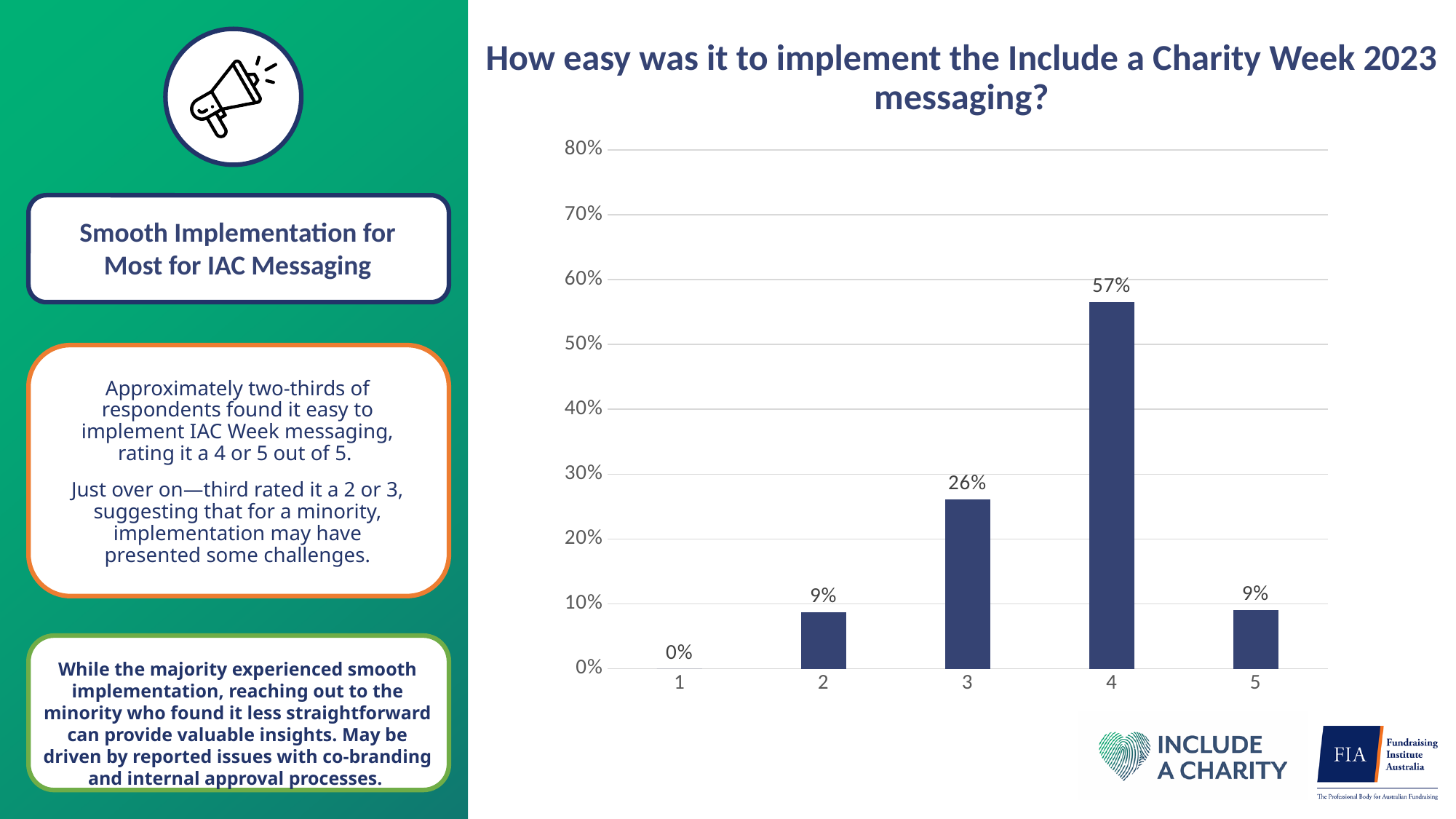
Is the value for rating 4 greater or less than 50%? greater How many rating categories are shown on the x axis? 5 What percentage of respondents rated the ease of implementation as 1? 0% Which rating received the lowest percentage of respondents? 1 Which rating has a larger share of respondents, 3 or 5? 3 What is the difference in percentage points between rating 4 and rating 3? 31% Which rating received the highest percentage of respondents? 4 What percentage of respondents rated the ease of implementation as 4? 57% What type of chart is shown on the slide? Bar chart What percentage of respondents rated the ease of implementation as 3? 26% What is the title of the chart? How easy was it to implement the Include a Charity Week 2023 messaging? What percentage of respondents rated the ease of implementation as 5? 9%